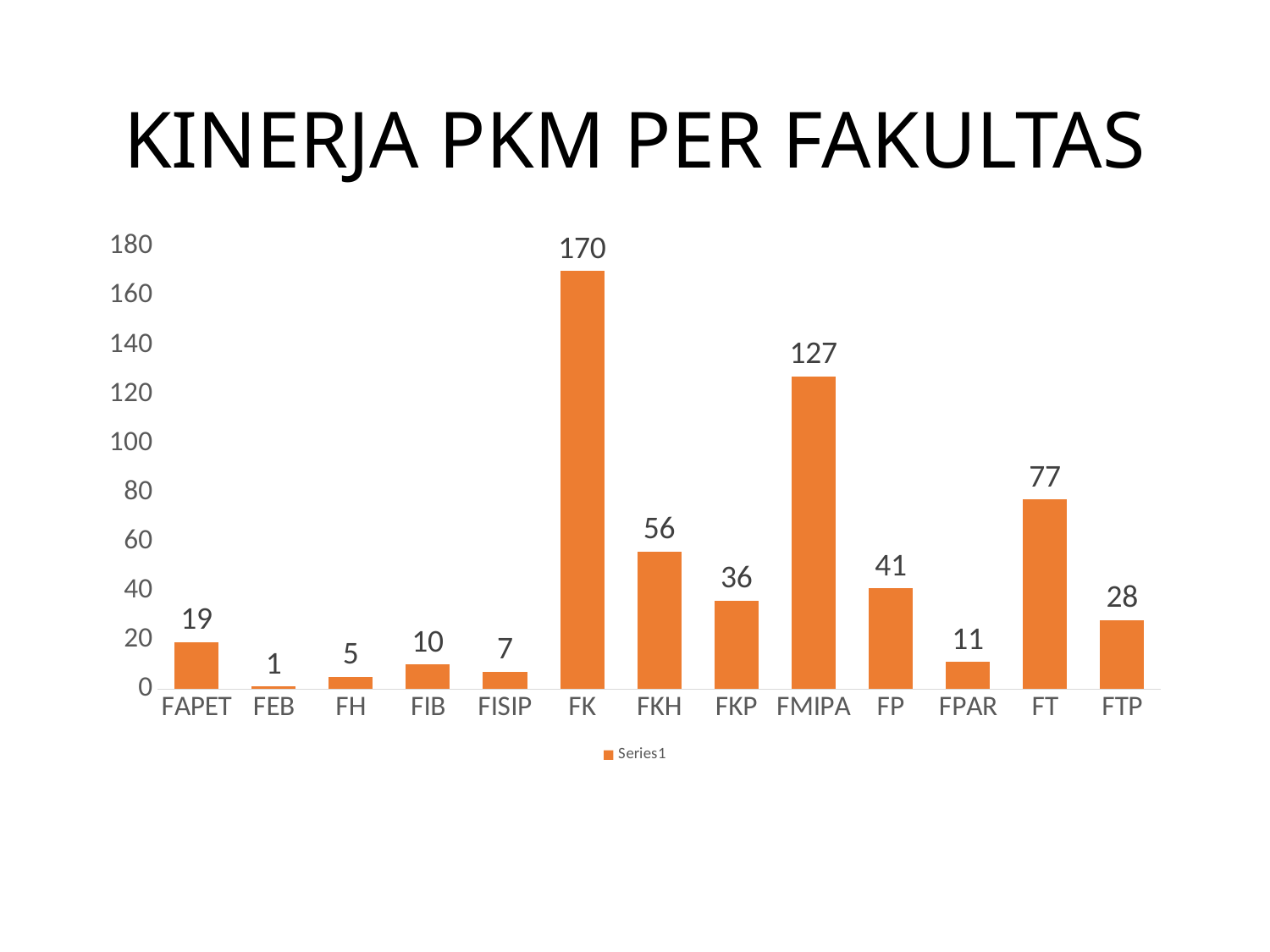
What kind of chart is shown on the slide? bar chart What is the value for FK? 170 Which category has the highest value? FK Which category has the lowest value? FEB What is the difference between the values for FK and FMIPA? 43 How many series does the legend list? 1 What is the value for FMIPA? 127 How many categories are shown on the x axis? 13 Which is larger, the value for FT or the value for FKH? FT Is the value for FKP greater or less than 40? less What is the title of the slide? KINERJA PKM PER FAKULTAS What is the value for FPAR? 11